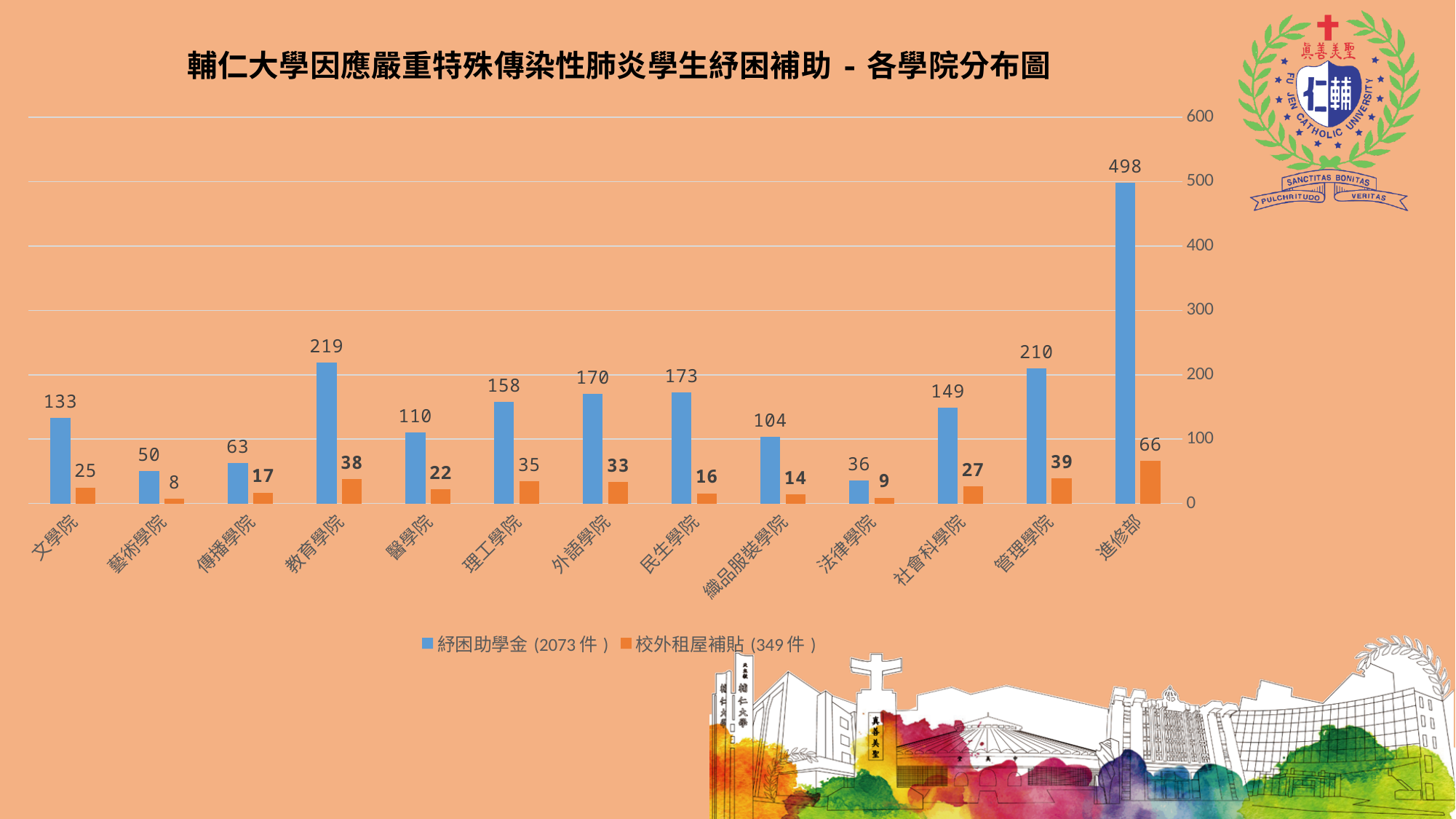
What is the difference between the 紓困助學金 values for 管理學院 and 社會科學院? 61 What is the 紓困助學金 value for 織品服裝學院? 104 What is the 校外租屋補貼 value for 進修部? 66 What kind of chart is shown on the slide? bar chart Is the 紓困助學金 value for 法律學院 greater or less than 100? less How many categories are shown on the x axis? 13 How many series does the legend list? 2 What total number of cases does the legend give for 校外租屋補貼? 349 件 What is the 紓困助學金 value for 教育學院? 219 Which category has the highest 紓困助學金 value? 進修部 Which has a larger 紓困助學金 value, 民生學院 or 外語學院? 民生學院 Which category has the lowest 校外租屋補貼 value? 藝術學院